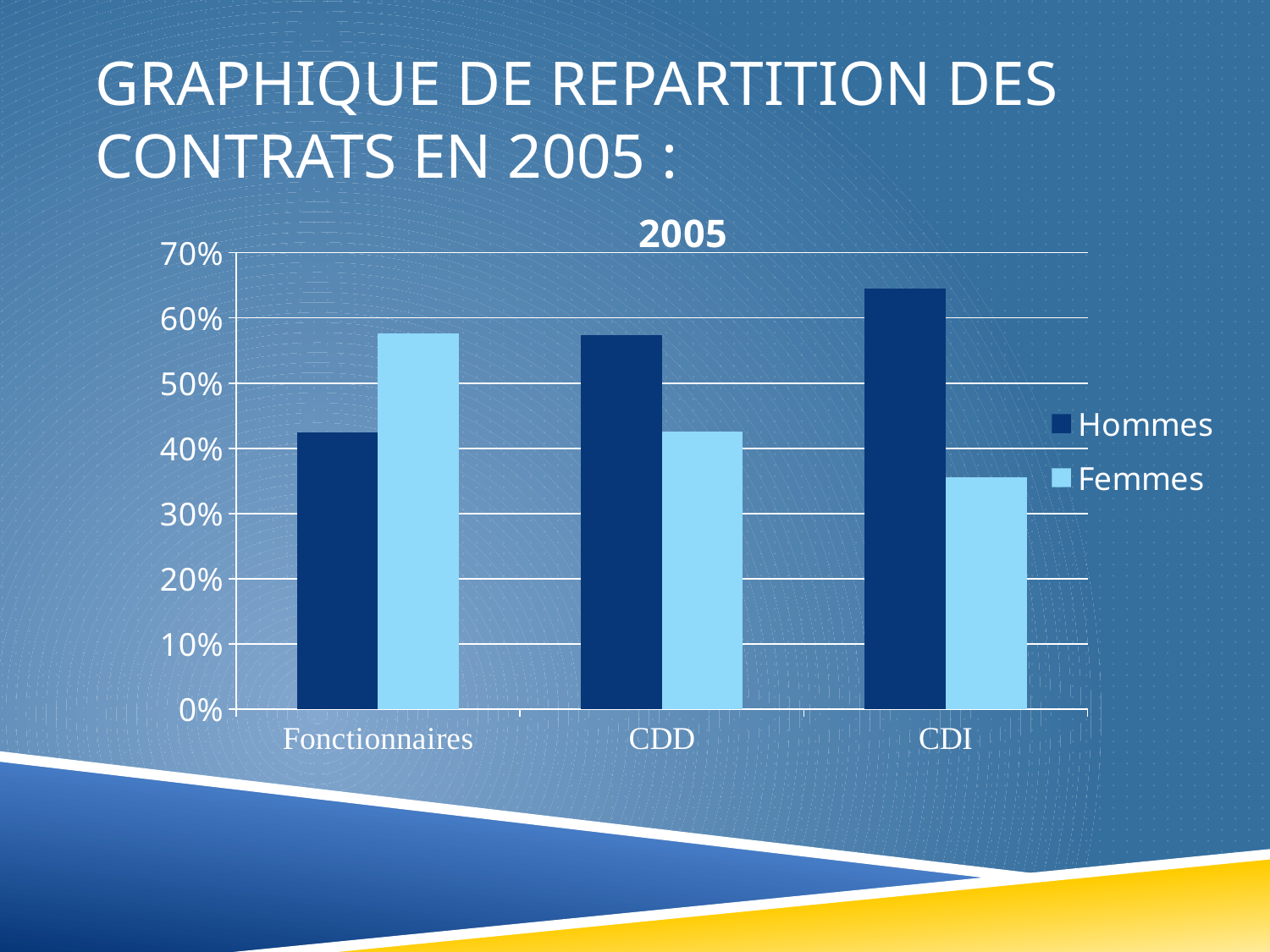
How many series does the legend list? 2 For which category is the Femmes value lowest? CDI What is the title of the chart? 2005 How many contract categories are shown on the x axis? 3 Is the Hommes value for CDI greater or less than 60%? greater For which category is the Hommes value lowest? Fonctionnaires For Fonctionnaires, which is larger: Hommes or Femmes? Femmes For which category is the Hommes value highest? CDI For CDI, which is larger: Hommes or Femmes? Hommes Which series is shown in the lighter blue colour? Femmes What kind of chart is shown on the slide? bar chart For which category is the Femmes value highest? Fonctionnaires